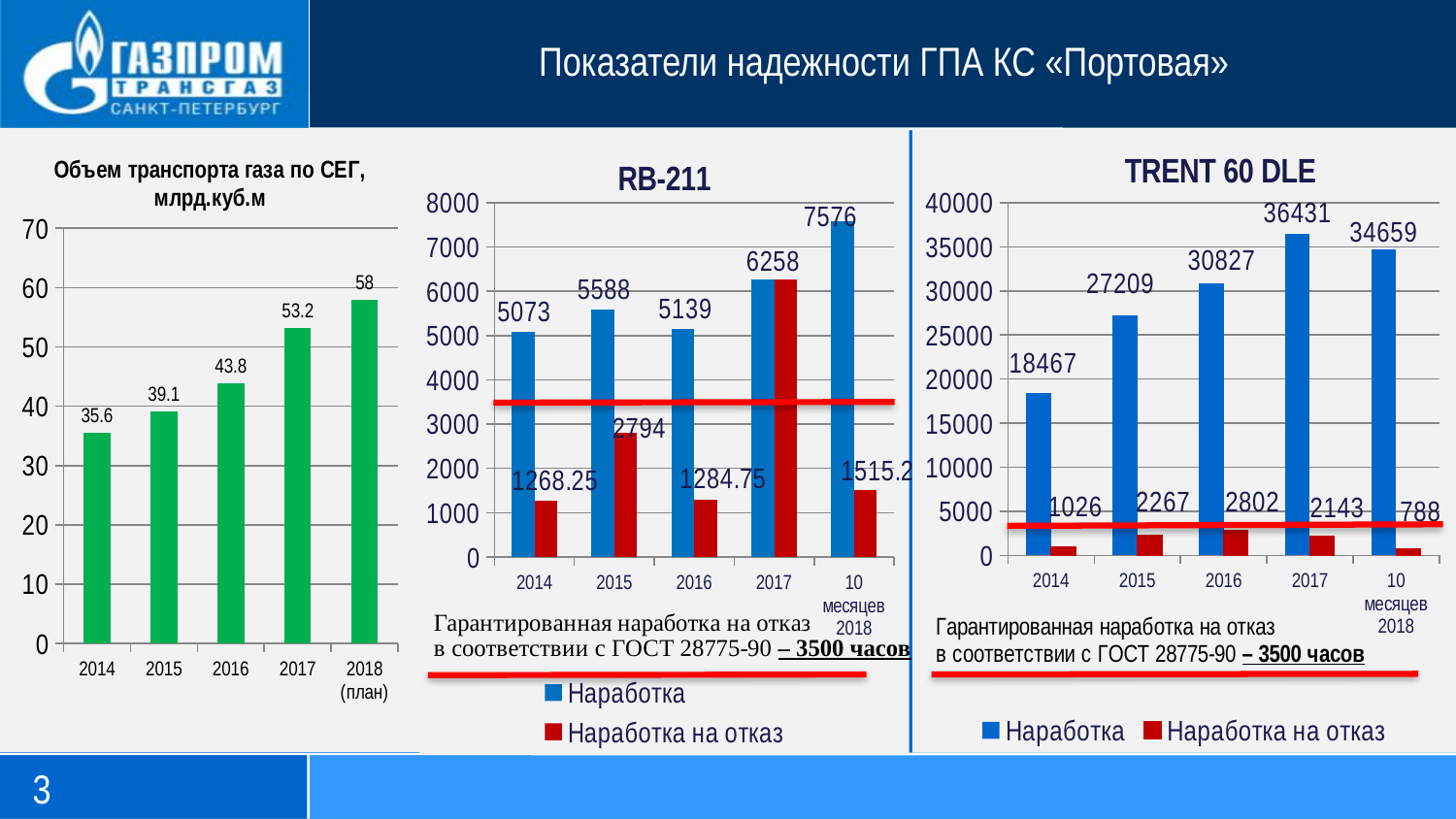
In the TRENT 60 DLE chart, what is the Наработка value for 2017? 36431 In the RB-211 chart, how many series does the legend list? 2 In the TRENT 60 DLE chart, what is the difference between the Наработка values for 2015 and 2014? 8742 In the RB-211 chart, what is the Наработка на отказ value for 2016? 1284.75 In the RB-211 chart, which period has the highest Наработка value? 10 месяцев 2018 In the RB-211 chart, what is the Наработка value for 2015? 5588 In the chart 'Объем транспорта газа по СЕГ, млрд.куб.м', what is the difference between the 2018 (план) value and the 2017 value? 4.8 In the chart 'Объем транспорта газа по СЕГ, млрд.куб.м', which year has the lowest value? 2014 In the chart 'Объем транспорта газа по СЕГ, млрд.куб.м', do the values rise or fall from 2014 to 2018 (план)? rise In the chart 'Объем транспорта газа по СЕГ, млрд.куб.м', what is the value for 2016? 43.8 What kind of chart is the TRENT 60 DLE chart? bar chart In the TRENT 60 DLE chart, which period has the lowest Наработка на отказ value? 10 месяцев 2018